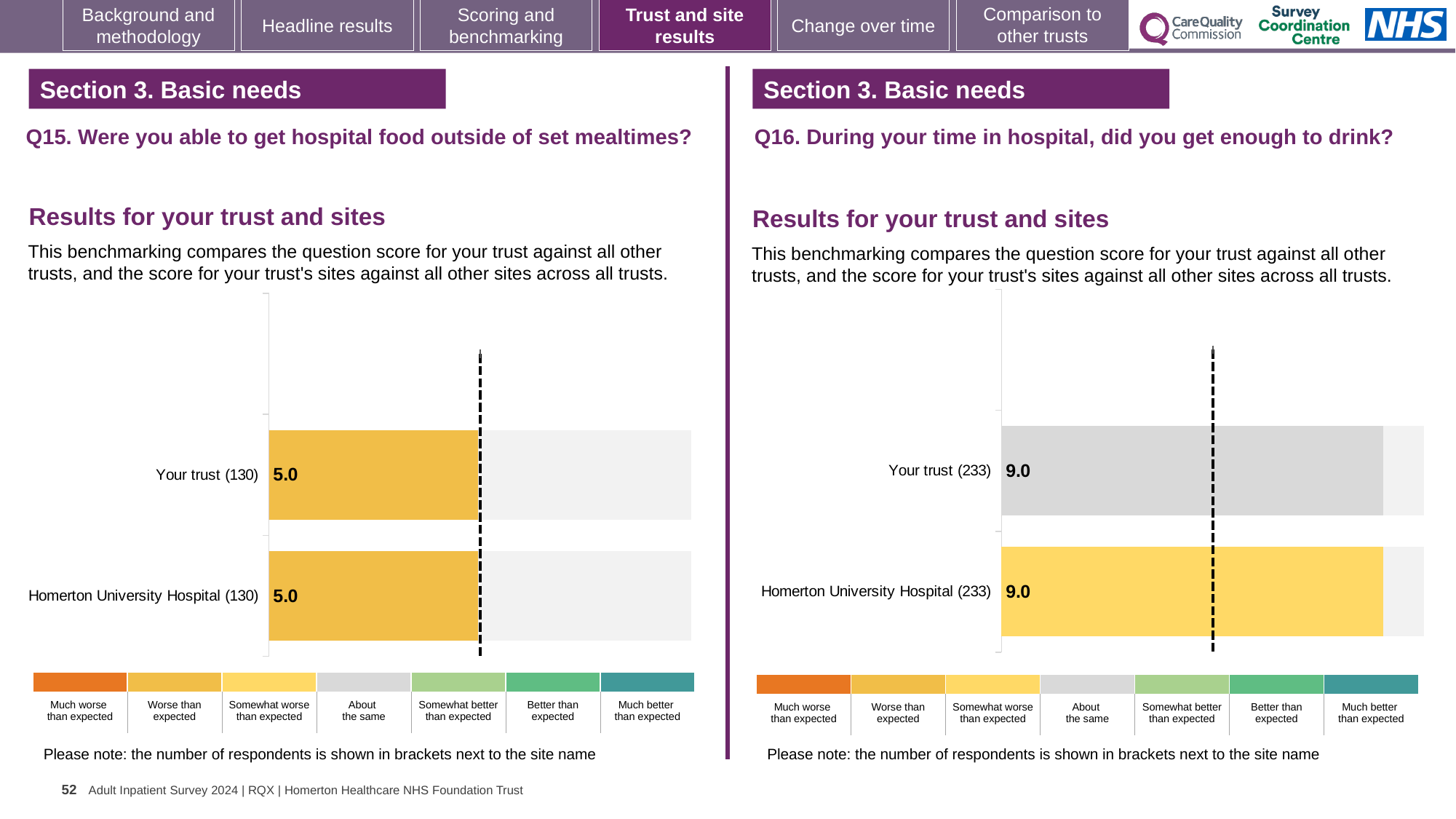
On the Q16 chart (right), which benchmark category does the colour of the Your trust bar correspond to? About the same On the Q16 chart (right), what is the score for Your trust? 9.0 On the Q15 chart (left), what is the score for Your trust? 5.0 What kind of chart is the Q15 chart (left)? Bar chart On the Q16 chart (right), what is the score for Homerton University Hospital? 9.0 On the Q15 chart (left), what is the difference between the score for Your trust and the score for Homerton University Hospital? 0.0 On the Q15 chart (left), what is the score for Homerton University Hospital? 5.0 On the Q16 chart (right), how many respondents are shown in brackets for Homerton University Hospital? 233 On the Q15 chart (left), how many respondents are shown in brackets for Your trust? 130 On the Q16 chart (right), how many bars are plotted? 2 On the Q15 chart (left), which benchmark category does the colour of the Your trust bar correspond to? Worse than expected How many benchmark categories are shown in the colour key below the Q16 chart (right)? 7